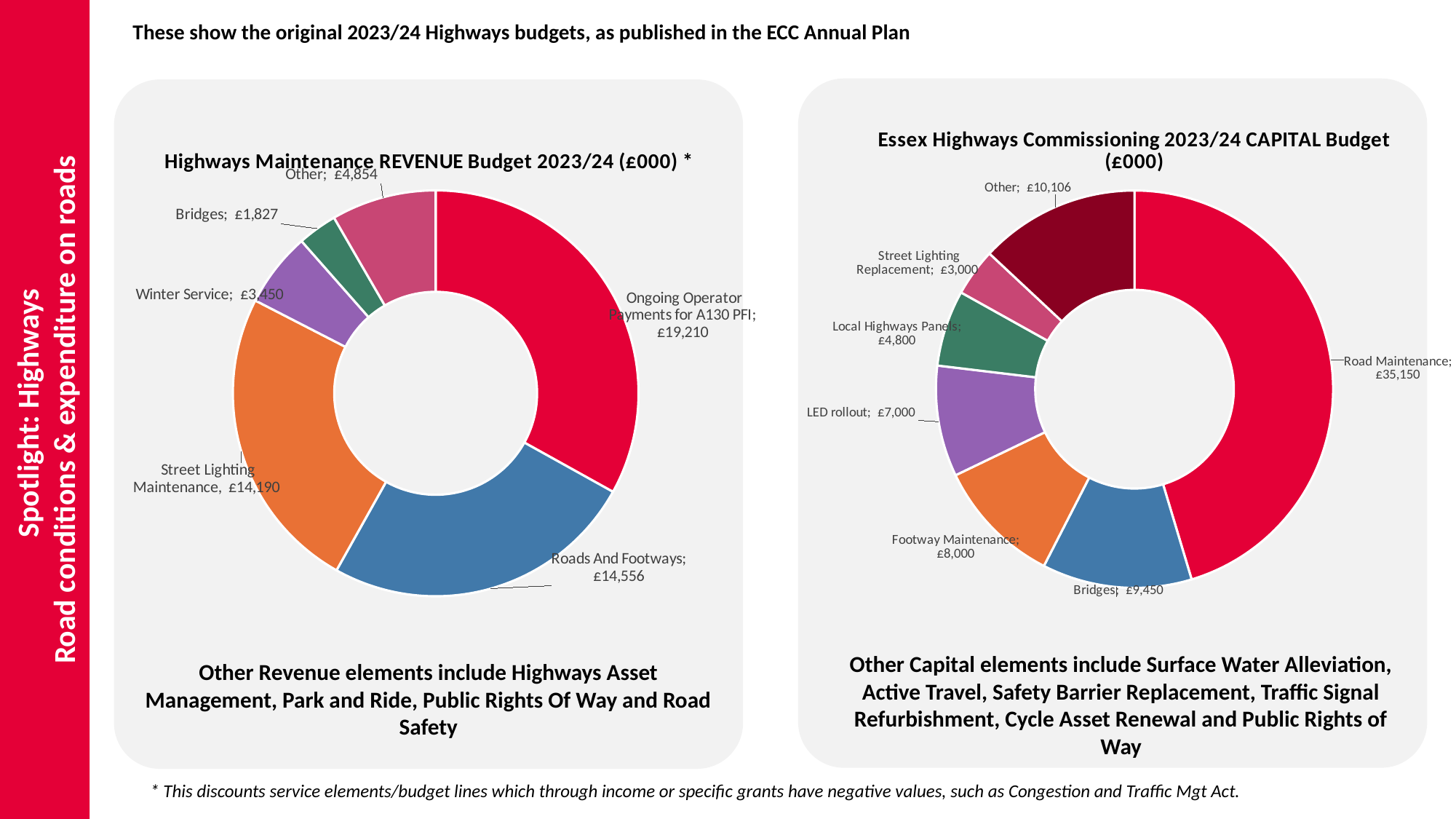
In the Essex Highways Commissioning 2023/24 CAPITAL Budget chart, which is larger: Footway Maintenance or LED rollout? Footway Maintenance In the Essex Highways Commissioning 2023/24 CAPITAL Budget chart, what is the value for Road Maintenance? £35,150 In the Highways Maintenance REVENUE Budget 2023/24 chart, which category has the largest value? Ongoing Operator Payments for A130 PFI In the Highways Maintenance REVENUE Budget 2023/24 chart, what is the value for Winter Service? £3,450 How many categories are shown in the Essex Highways Commissioning 2023/24 CAPITAL Budget chart? 7 In the Highways Maintenance REVENUE Budget 2023/24 chart, which category has the smallest value? Bridges In the Essex Highways Commissioning 2023/24 CAPITAL Budget chart, which category has the smallest value? Street Lighting Replacement In the Highways Maintenance REVENUE Budget 2023/24 chart, how much larger is Roads And Footways than Street Lighting Maintenance? £366 In the Highways Maintenance REVENUE Budget 2023/24 chart, what is the value for Roads And Footways? £14,556 How many categories are shown in the Highways Maintenance REVENUE Budget 2023/24 chart? 6 In the Essex Highways Commissioning 2023/24 CAPITAL Budget chart, what is the value for Local Highways Panels? £4,800 What type of chart is used on the left of the slide for the Highways Maintenance REVENUE Budget 2023/24? Pie (doughnut) chart